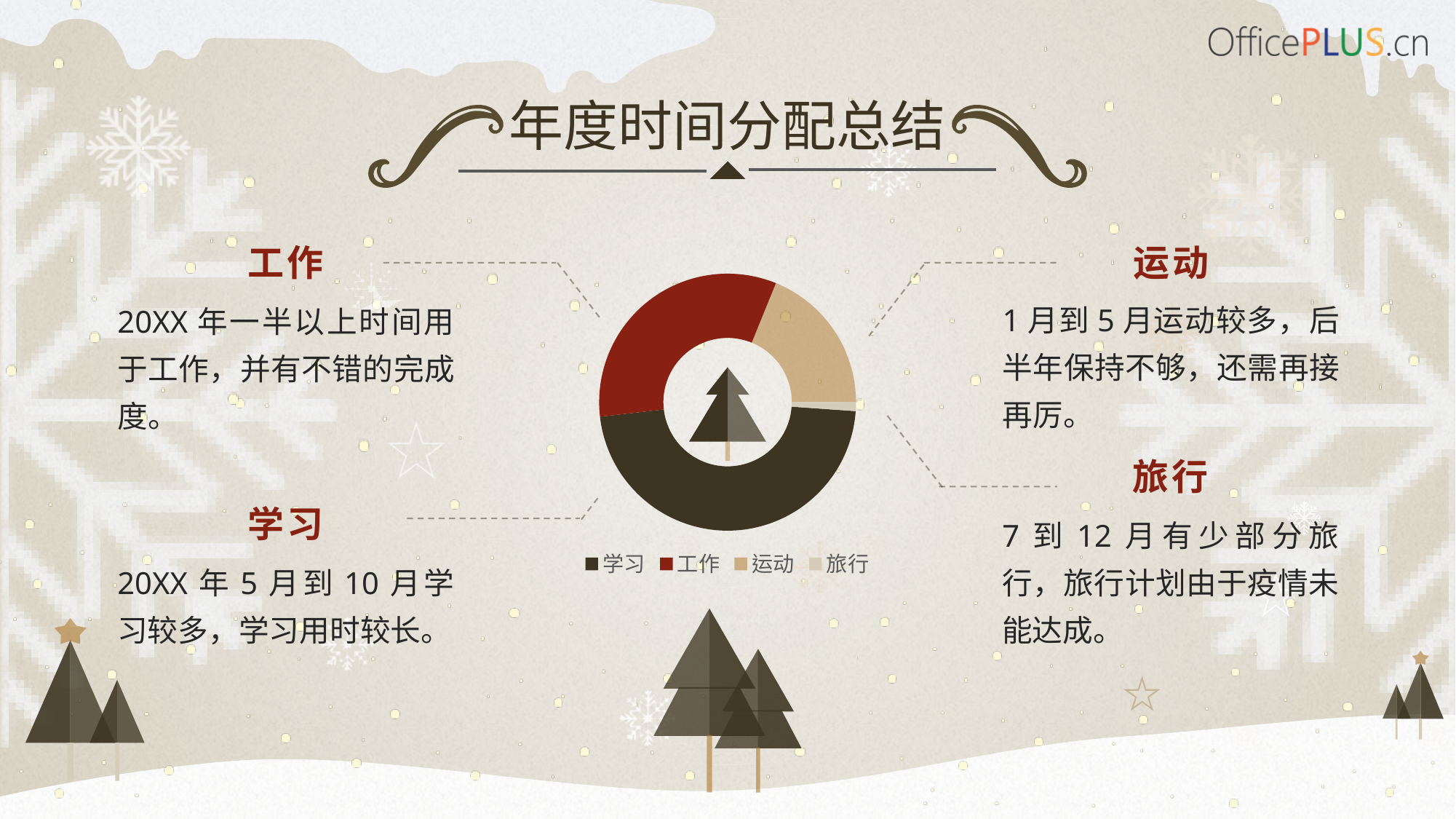
Which category takes up the largest share of the chart? 学习 How many categories does the chart show? 4 How many entries does the chart legend list? 4 Which category has the larger share, 学习 or 工作? 学习 Which category has the larger share, 运动 or 旅行? 运动 Which category is shown in red in the chart? 工作 Which category has the larger share, 工作 or 运动? 工作 What is the title of the slide containing the chart? 年度时间分配总结 Which category takes up the smallest share of the chart? 旅行 What kind of chart is shown on the slide? doughnut chart